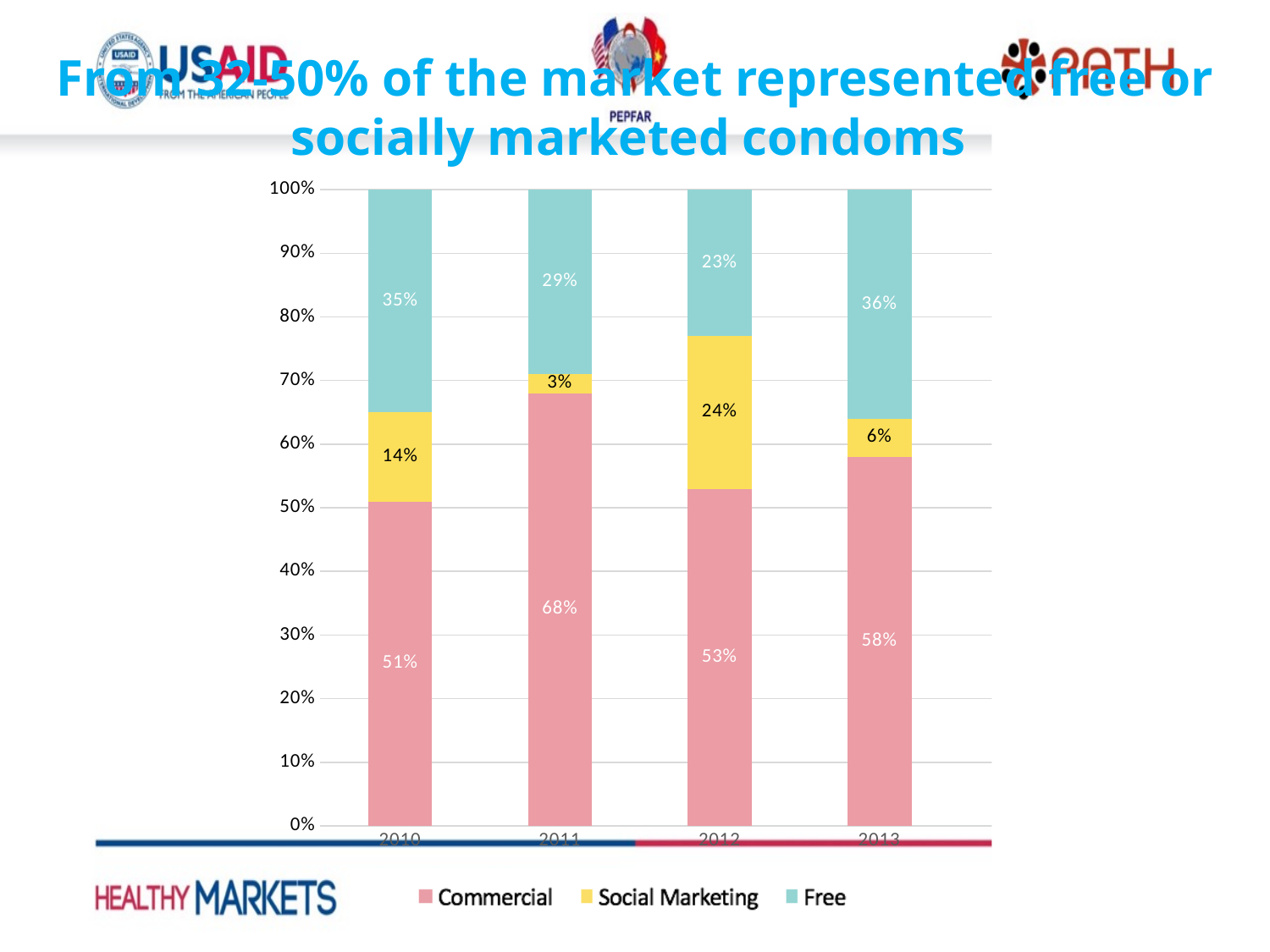
What kind of chart is shown on the slide? Stacked bar chart In which year is the Commercial share highest? 2011 How many series does the legend list? 3 What is the combined share of Social Marketing and Free in 2010? 49% Which is larger, the Commercial share in 2012 or the Commercial share in 2013? 2013 How many years are shown on the x axis? 4 What is the Commercial share in 2011? 68% In which year is the Social Marketing share lowest? 2011 Which series is shown in yellow in the legend? Social Marketing What is the Social Marketing share in 2012? 24% What is the Free share in 2013? 36% What is the difference between the Free share in 2010 and the Free share in 2012? 12%